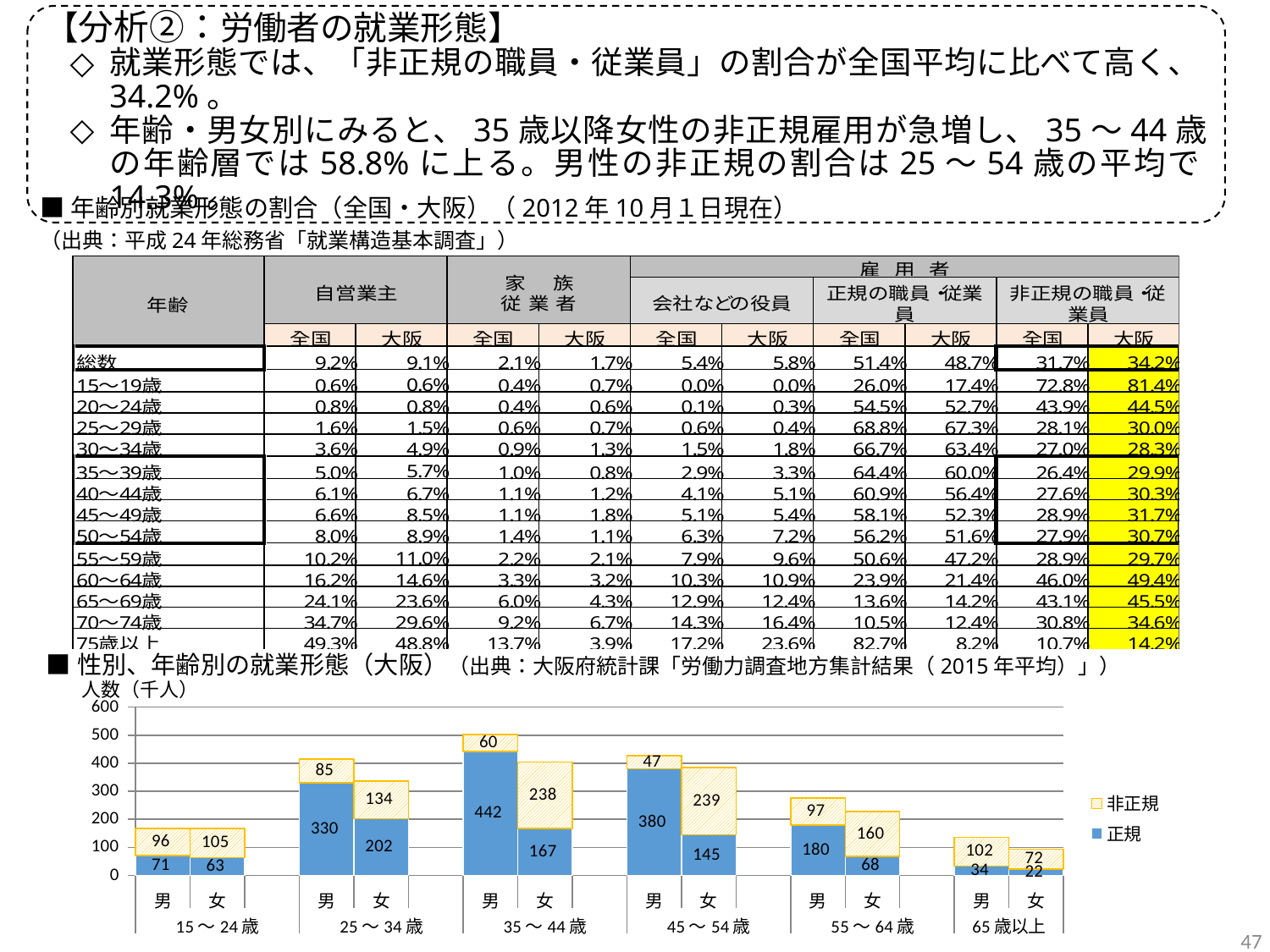
In the bar chart 性別、年齢別の就業形態（大阪）, what is the 非正規 value for 女 in the 55～64歳 group? 160 In the bar chart 性別、年齢別の就業形態（大阪）, what is the total (正規 plus 非正規) for 女 in the 35～44歳 group? 405 In the bar chart 性別、年齢別の就業形態（大阪）, which is larger: the 非正規 value for 女 in 25～34歳 or the 非正規 value for 男 in 25～34歳? 女 in 25～34歳 In the bar chart 性別、年齢別の就業形態（大阪）, what is the 非正規 value for 男 in the 15～24歳 group? 96 In the bar chart 性別、年齢別の就業形態（大阪）, which bar has the lowest 非正規 value? 男, 45～54歳 In the bar chart 性別、年齢別の就業形態（大阪）, what is the difference between the 正規 values for 男 and 女 in the 45～54歳 group? 235 In the bar chart 性別、年齢別の就業形態（大阪）, which bar has the lowest 正規 value? 女, 65歳以上 In the bar chart 性別、年齢別の就業形態（大阪）, what is the total (正規 plus 非正規) for 男 in the 35～44歳 group? 502 How many series does the legend of the bar chart 性別、年齢別の就業形態（大阪） list? 2 In the bar chart 性別、年齢別の就業形態（大阪）, which bar has the highest 正規 value? 男, 35～44歳 What kind of chart is 性別、年齢別の就業形態（大阪）? Stacked bar chart In the bar chart 性別、年齢別の就業形態（大阪）, what is the 正規 value for 男 in the 35～44歳 group? 442